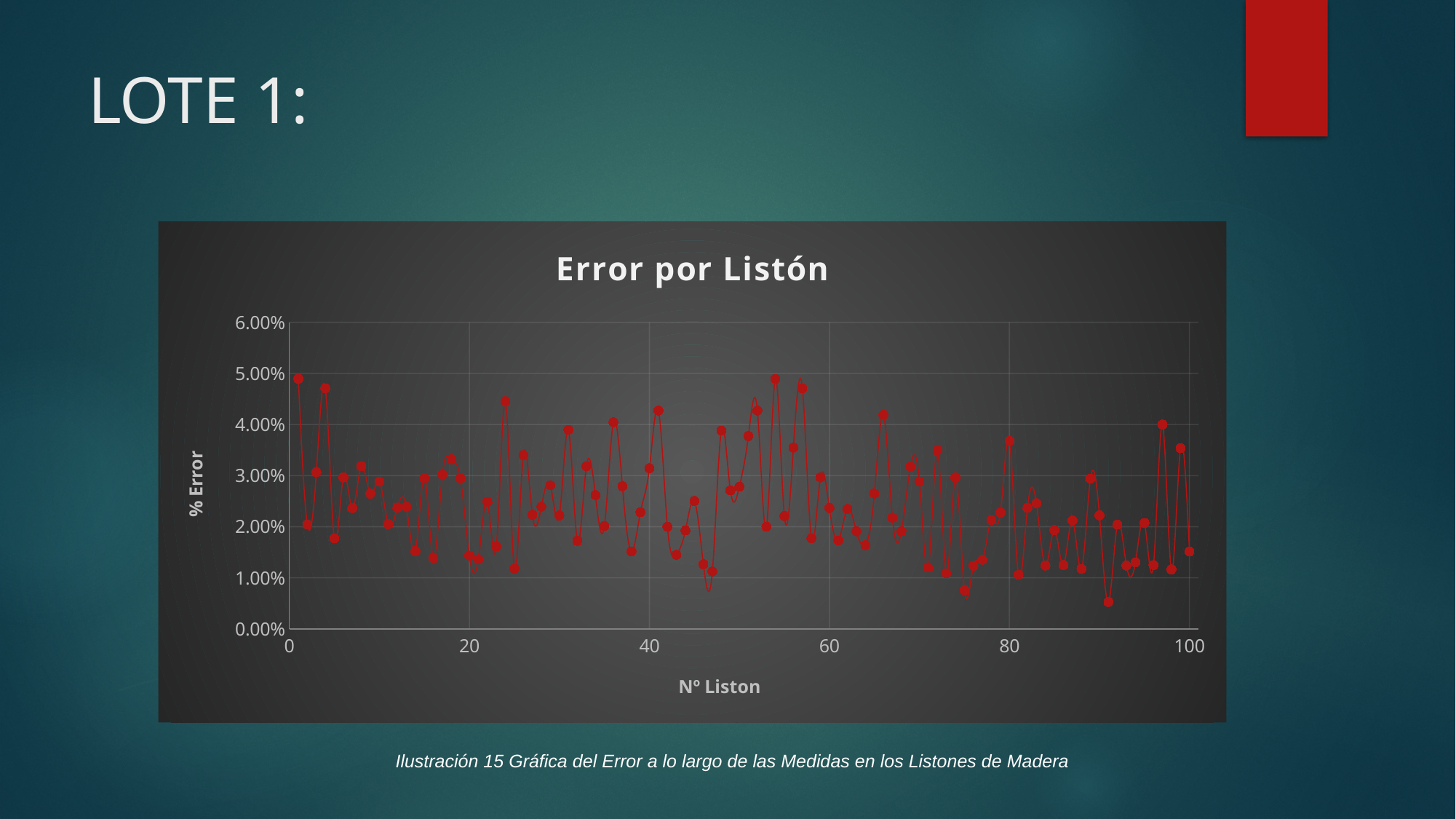
Which has the larger value, listón 1 or listón 2? listón 1 What is the label of the x axis of the chart? Nº Liston Which has the larger value, listón 24 or listón 25? listón 24 Is the value for listón 97 greater or less than 3.00%? greater What is the title of the chart? Error por Listón Is the value for listón 24 greater or less than 4.00%? greater Is the value for listón 54 greater or less than 4.00%? greater What kind of chart is shown on the slide? line chart